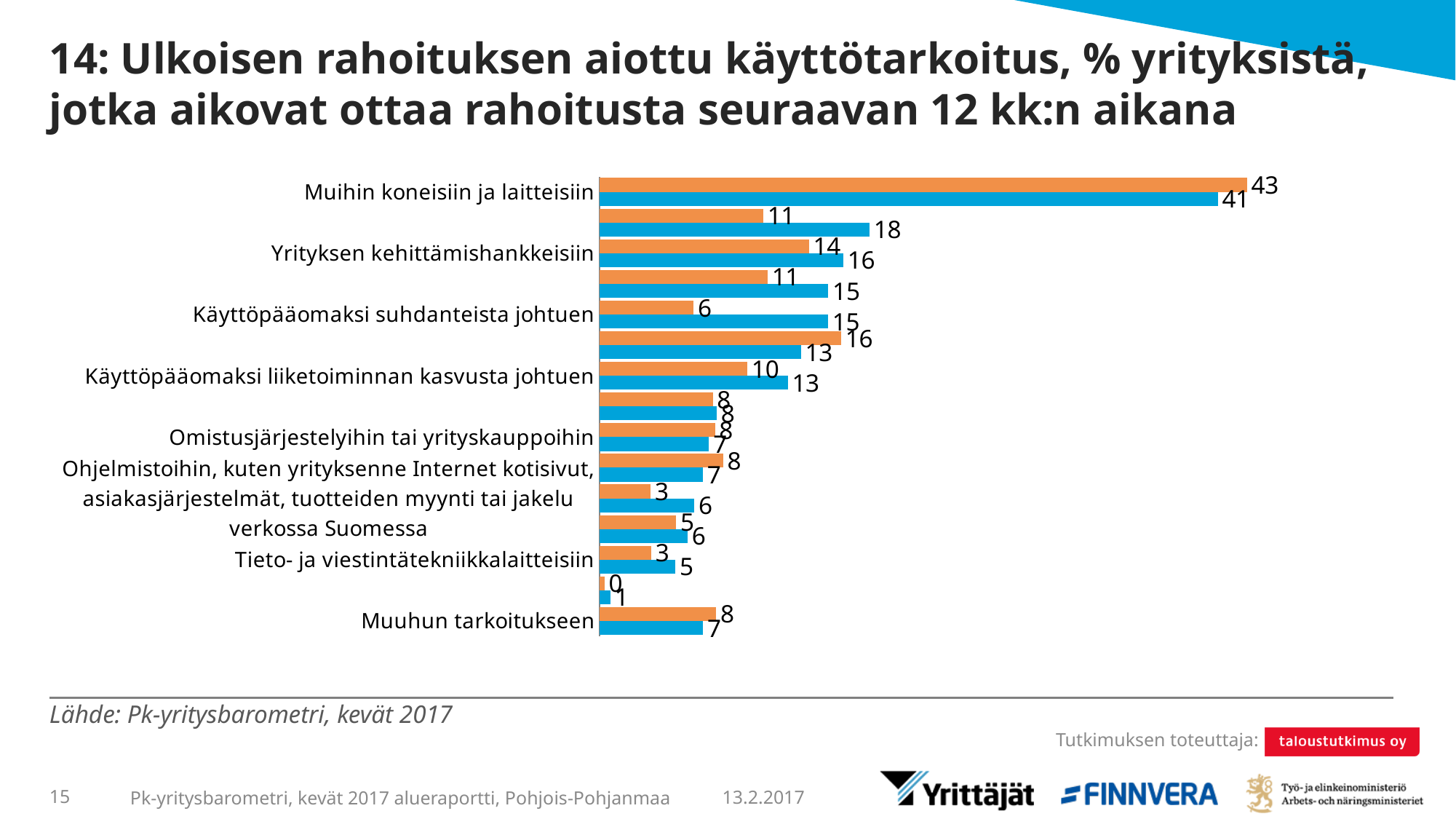
Which category has the highest orange bar? Muihin koneisiin ja laitteisiin What is the value of the blue bar for "Yrityksen kehittämishankkeisiin"? 16 What is the value of the orange bar for "Muihin koneisiin ja laitteisiin"? 43 What is the difference between the orange and blue bars for "Muihin koneisiin ja laitteisiin"? 2 What is the value of the blue bar for "Käyttöpääomaksi liiketoiminnan kasvusta johtuen"? 13 What is the difference between the blue and orange bars for "Käyttöpääomaksi liiketoiminnan kasvusta johtuen"? 3 How many bars are shown for each category in the chart? 2 What kind of chart is shown on the slide? bar chart For "Käyttöpääomaksi suhdanteista johtuen", which bar is larger, the orange or the blue one? blue What is the value of the orange bar for "Käyttöpääomaksi suhdanteista johtuen"? 6 What is the value of the orange bar for "Muuhun tarkoitukseen"? 8 What is the value of the blue bar for "Muihin koneisiin ja laitteisiin"? 41